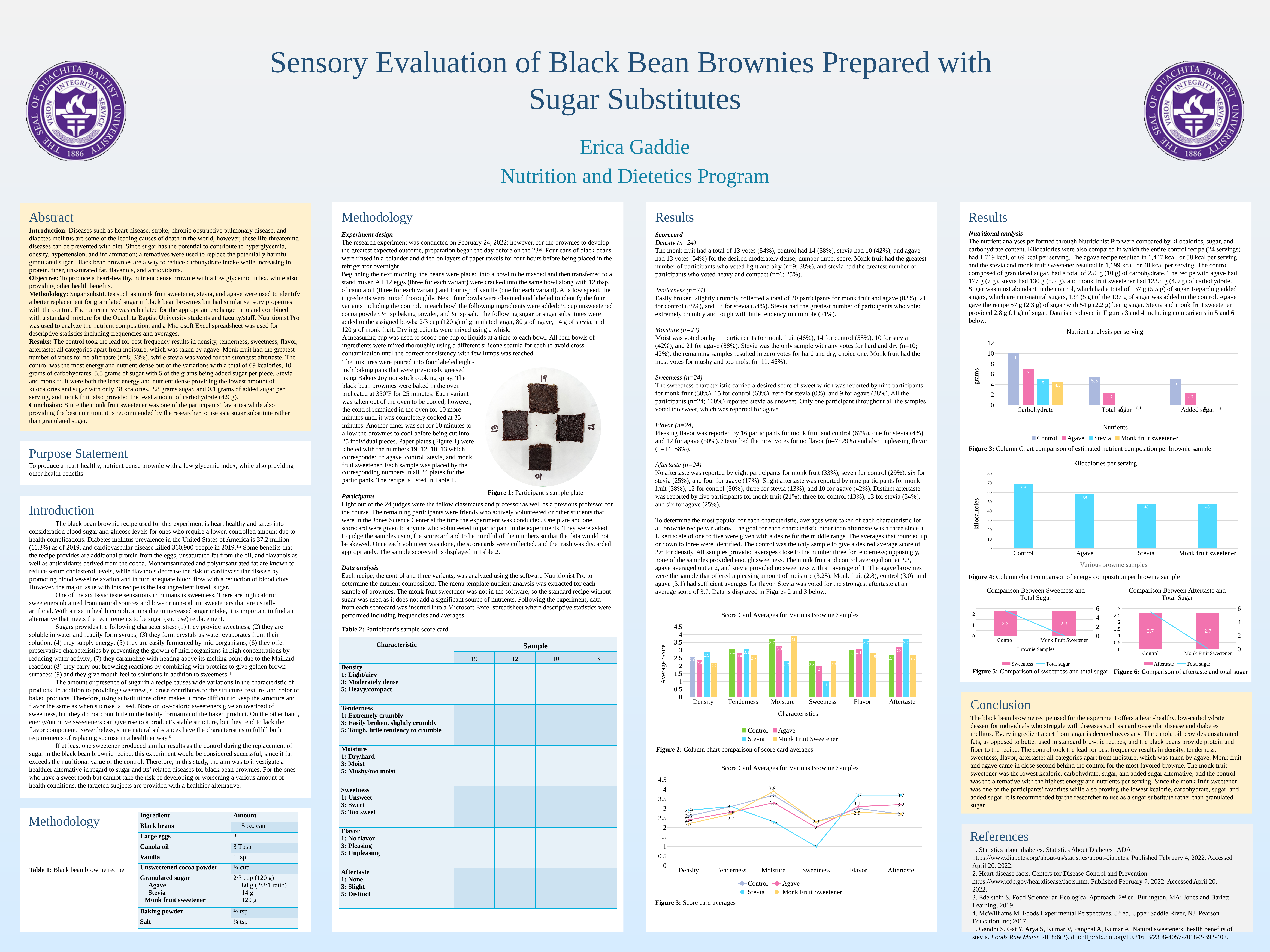
In the line chart 'Score Card Averages for Various Brownie Samples' (Figure 3), what is the Sweetness value for Stevia? 1 In the 'Nutrient analysis per serving' chart, which is larger for Carbohydrate: Stevia or Monk fruit sweetener? Stevia How many brownie samples are shown on the x axis of the 'Kilocalories per serving' chart? 4 How many series does the legend of the 'Nutrient analysis per serving' chart list? 4 What kind of chart is Figure 2, 'Score Card Averages for Various Brownie Samples'? Bar chart In the 'Comparison Between Aftertaste and Total Sugar' chart, what is the Aftertaste value for Monk Fruit Sweetener? 2.7 In the 'Nutrient analysis per serving' chart, what is the Carbohydrate value for Agave? 7 In the 'Nutrient analysis per serving' chart, what is the Carbohydrate value for Control? 10 In the 'Kilocalories per serving' chart, which brownie sample has the highest kilocalories? Control In the line chart 'Score Card Averages for Various Brownie Samples' (Figure 3), which sample has the lowest Sweetness score? Stevia In the 'Kilocalories per serving' chart, what is the value for Control? 69 In the 'Kilocalories per serving' chart, what is the difference in kilocalories between Control and Agave? 11